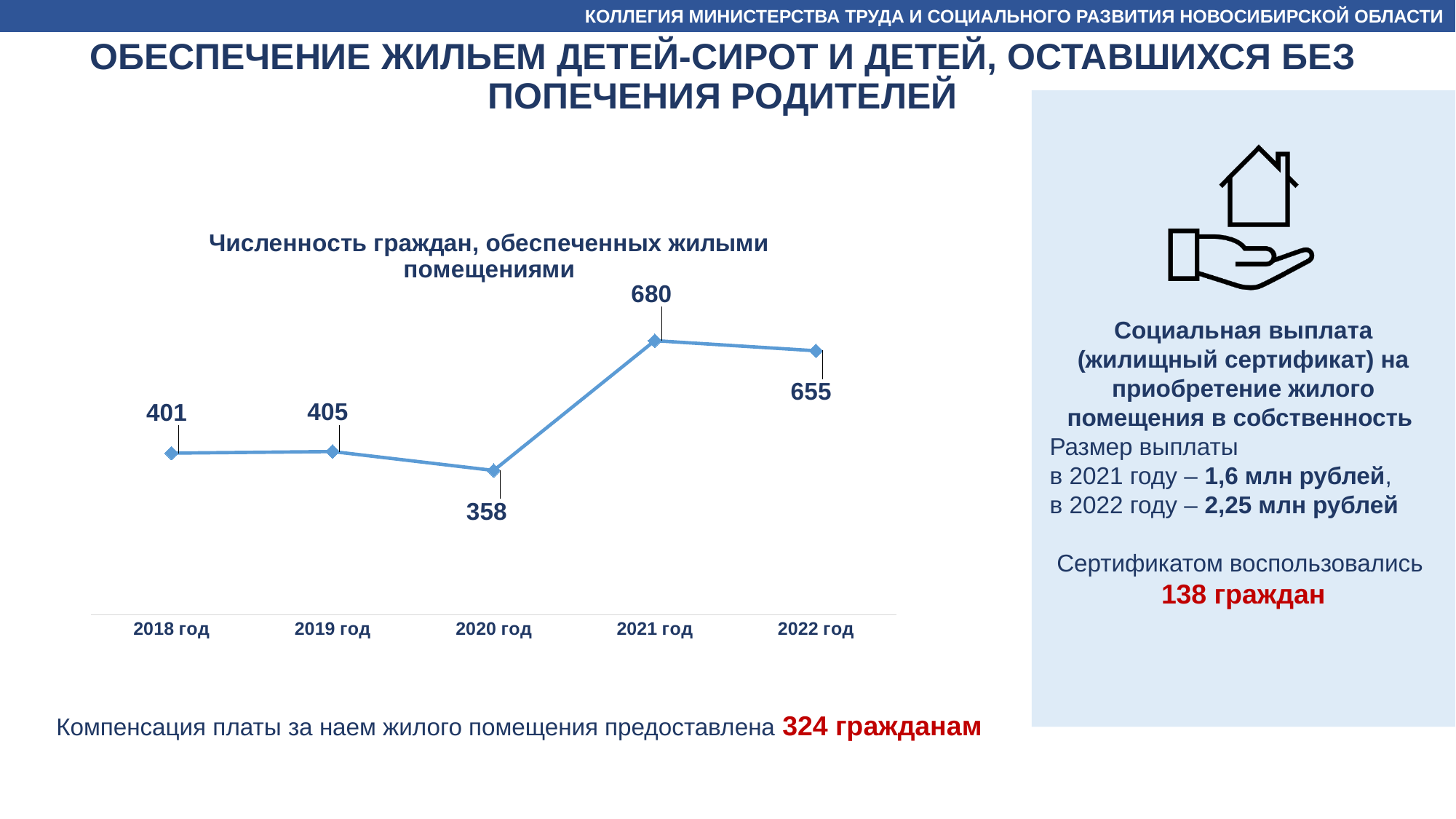
Does the value rise or fall from 2020 год to 2021 год? rise What is the difference between the values for 2021 год and 2020 год? 322 What is the value for 2018 год? 401 Which year has the lowest value? 2020 год What is the difference between the values for 2022 год and 2018 год? 254 Which year has the highest value? 2021 год What kind of chart is shown on the slide? line chart What is the title of the chart? Численность граждан, обеспеченных жилыми помещениями What is the value for 2020 год? 358 What is the value for 2022 год? 655 How many years are plotted on the chart? 5 Which is larger, the value for 2021 год or the value for 2022 год? 2021 год